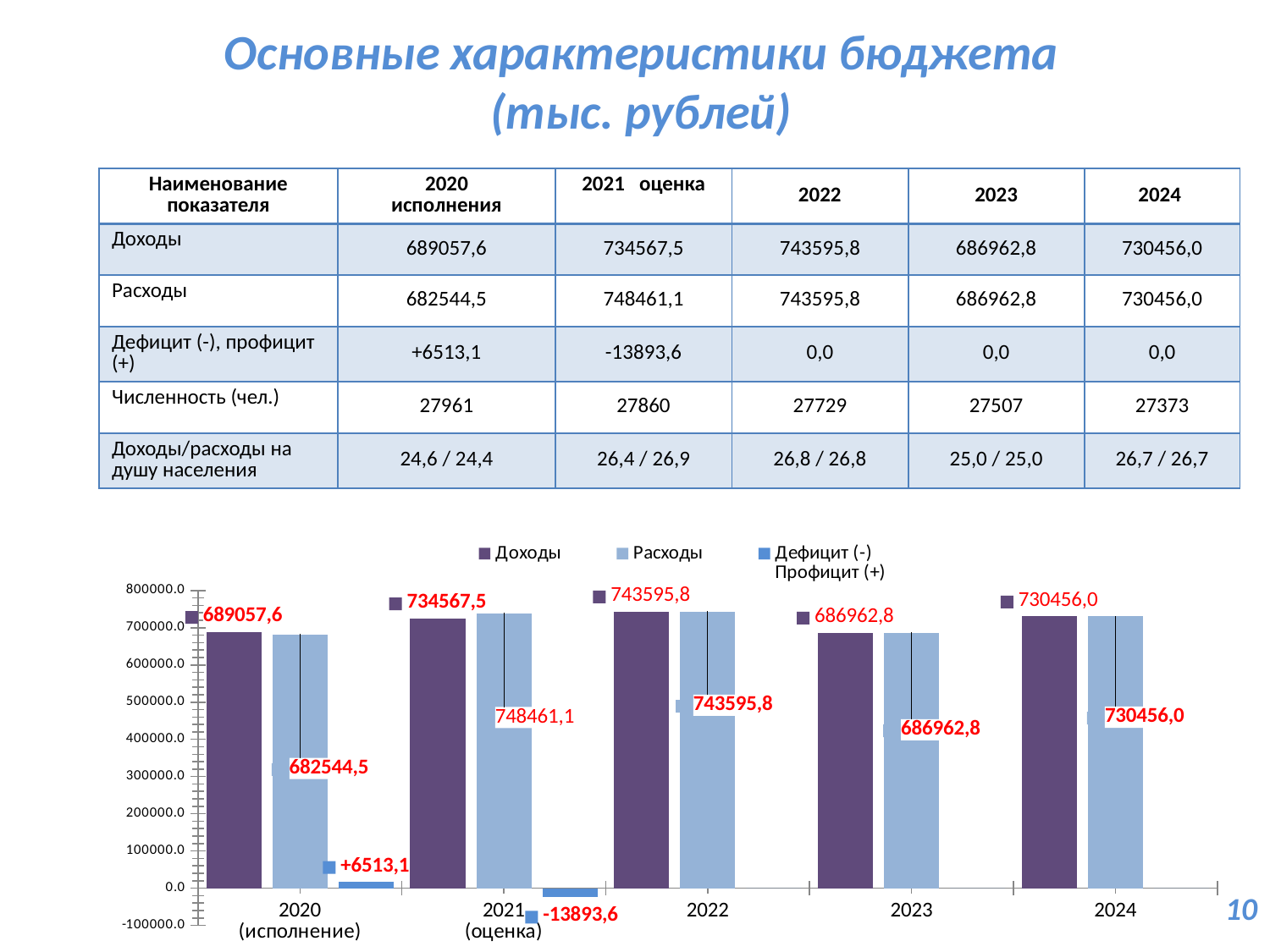
How many year categories are shown on the x axis of the chart? 5 What is the value of the Дефицит (-) Профицит (+) series for 2021 (оценка) in the chart? -13893,6 Is the Доходы value for 2023 in the chart greater or less than 700000? less How many series does the chart legend list? 3 What is the value of the Дефицит (-) Профицит (+) series for 2020 (исполнение) in the chart? +6513,1 Which year has the lowest Расходы value in the chart? 2020 (исполнение) What type of chart is shown on the slide? bar chart Which is larger in the chart for 2021 (оценка): Доходы or Расходы? Расходы What is the value of Расходы for 2021 (оценка) in the chart? 748461,1 What is the value of Доходы for 2020 (исполнение) in the chart? 689057,6 What is the difference between Расходы and Доходы for 2021 (оценка) in the chart? 13893,6 Which year has the highest Доходы value in the chart? 2022